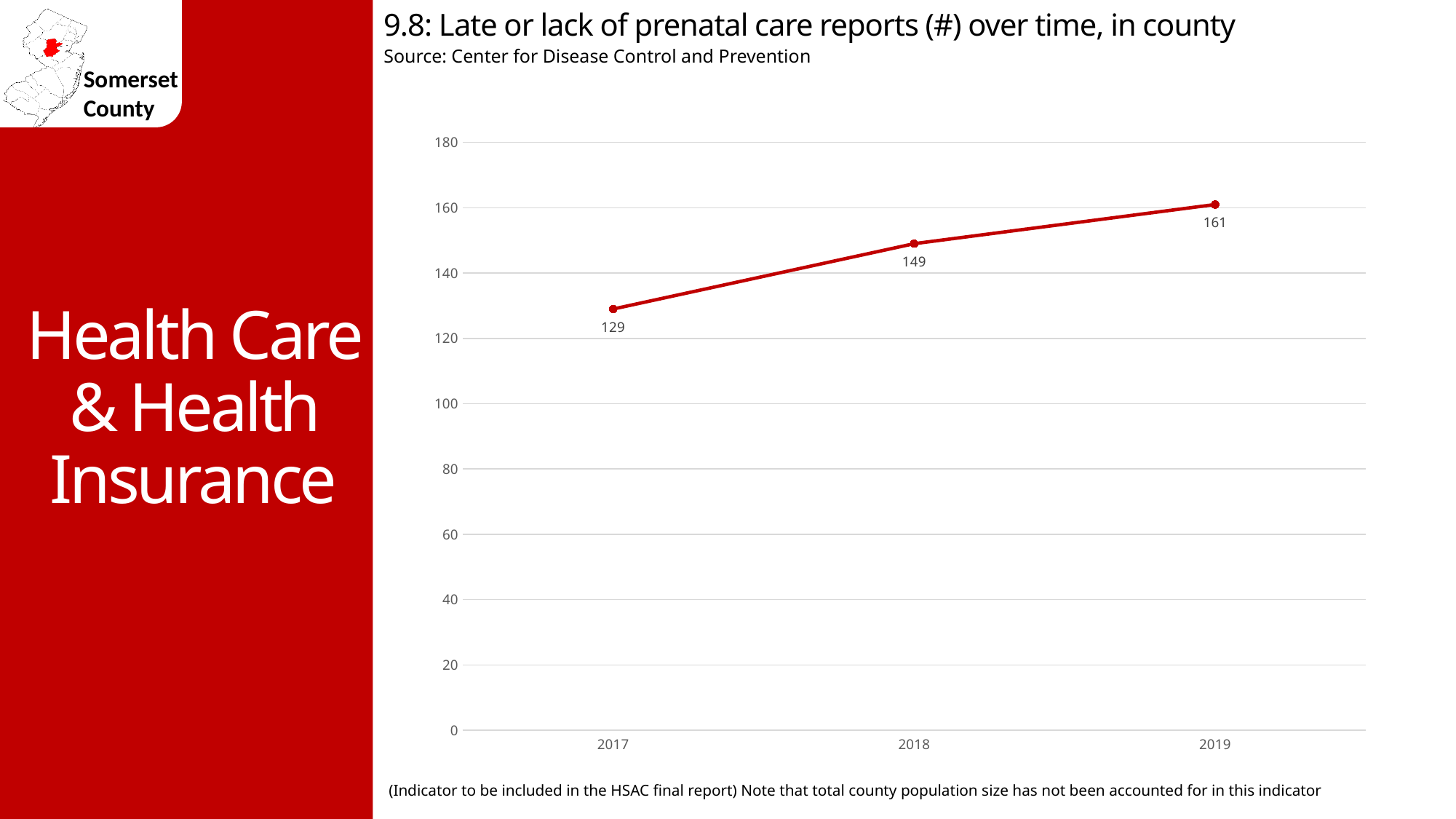
What kind of chart is shown on the slide? Line chart What is the difference between the number of reports in 2019 and in 2017? 32 How many years are plotted on the chart? 3 What is the number of late or lack of prenatal care reports in 2017? 129 Which year has more reports, 2018 or 2019? 2019 Is the value for 2018 greater or less than 140? greater Which year has the lowest number of late or lack of prenatal care reports? 2017 Which year has the highest number of late or lack of prenatal care reports? 2019 Do the values rise or fall from 2017 to 2019? Rise What is the difference between the number of reports in 2018 and in 2017? 20 What is the number of late or lack of prenatal care reports in 2019? 161 What is the number of late or lack of prenatal care reports in 2018? 149